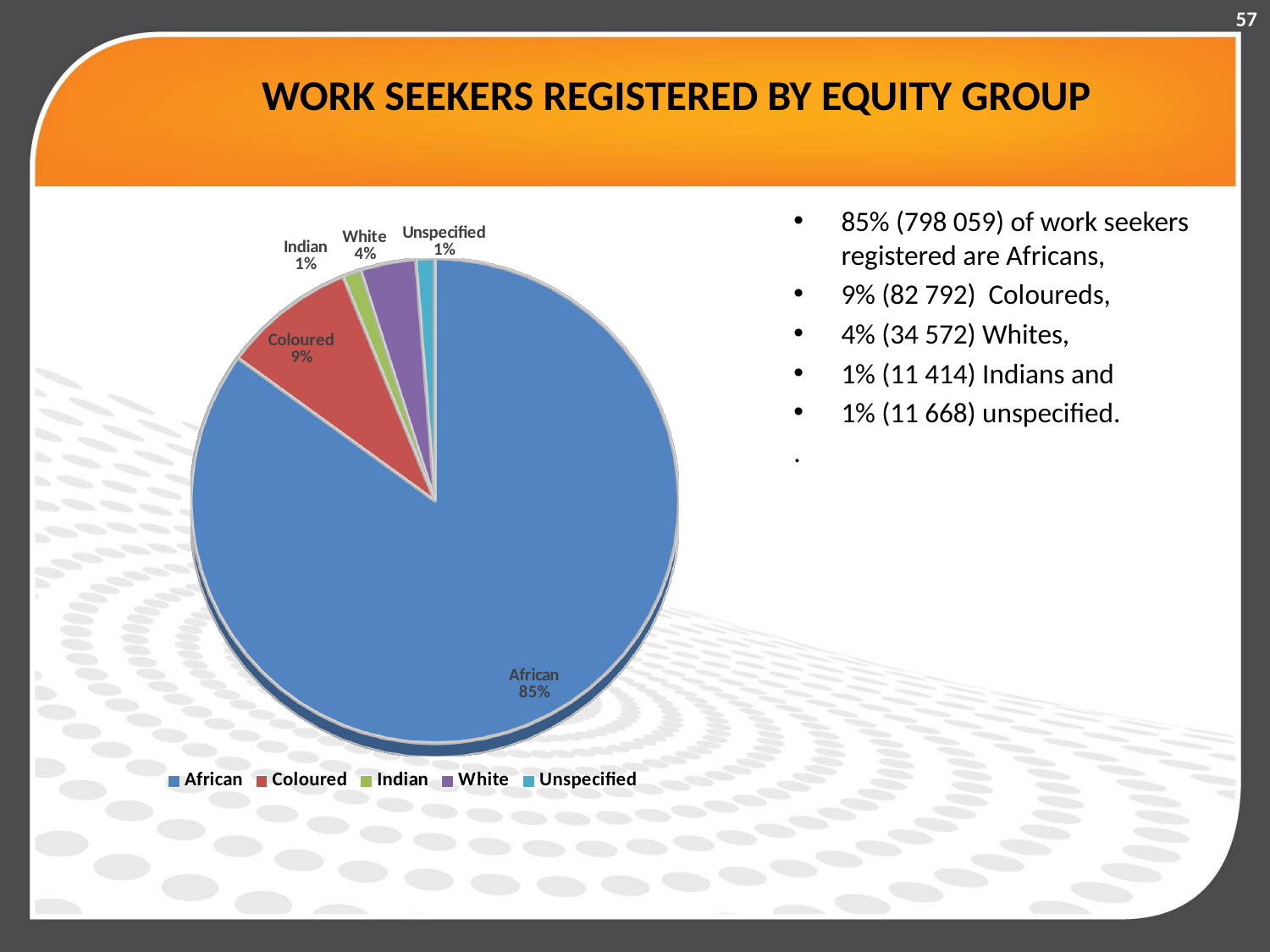
How many slices does the pie chart have? 5 Which equity group has the largest slice of the pie? African What percentage is shown for the Indian slice? 1% What percentage is shown for the Unspecified slice? 1% What percentage is shown for the White slice? 4% What is the difference in percentage points between the African and Coloured slices? 76 What share of the pie does the African slice represent? 85% What type of chart is shown on the slide? Pie chart What colour is the African slice in the pie chart? Blue What percentage is shown for the Coloured slice? 9% How many entries does the legend list? 5 Which slice is larger, Coloured or White? Coloured